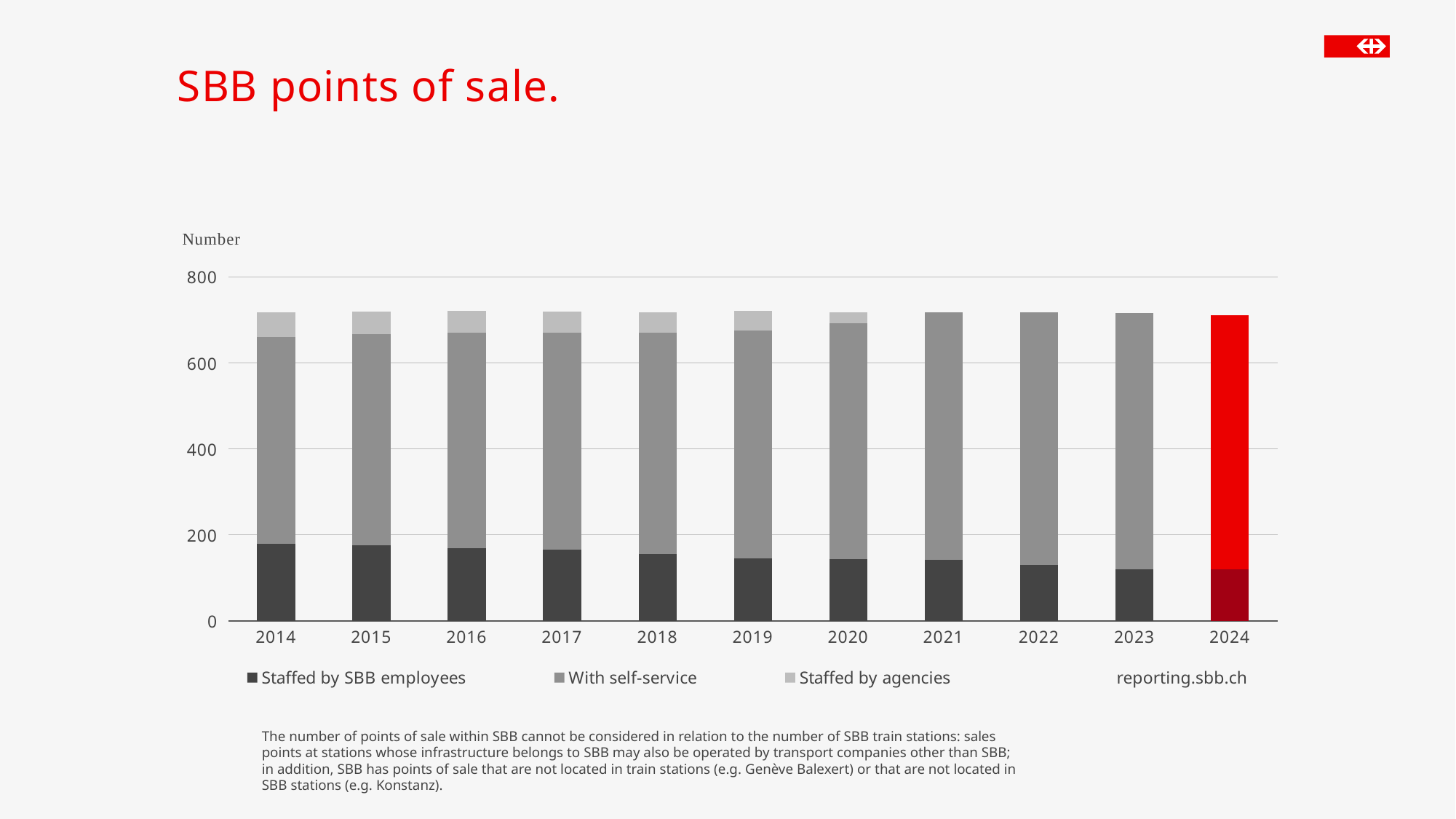
What label is shown on the vertical axis of the chart? Number What is the title of the slide? SBB points of sale. Is the value for 'Staffed by SBB employees' in 2014 greater or less than 200? less Is the value for 'Staffed by SBB employees' in 2024 greater or less than 200? less How many years are shown on the x axis of the chart? 11 Does the 'Staffed by SBB employees' segment rise or fall from 2014 to 2024? fall What kind of chart is shown on the slide? stacked bar chart Is the total number of points of sale in 2019 greater or less than 800? less How many series does the chart legend list? 3